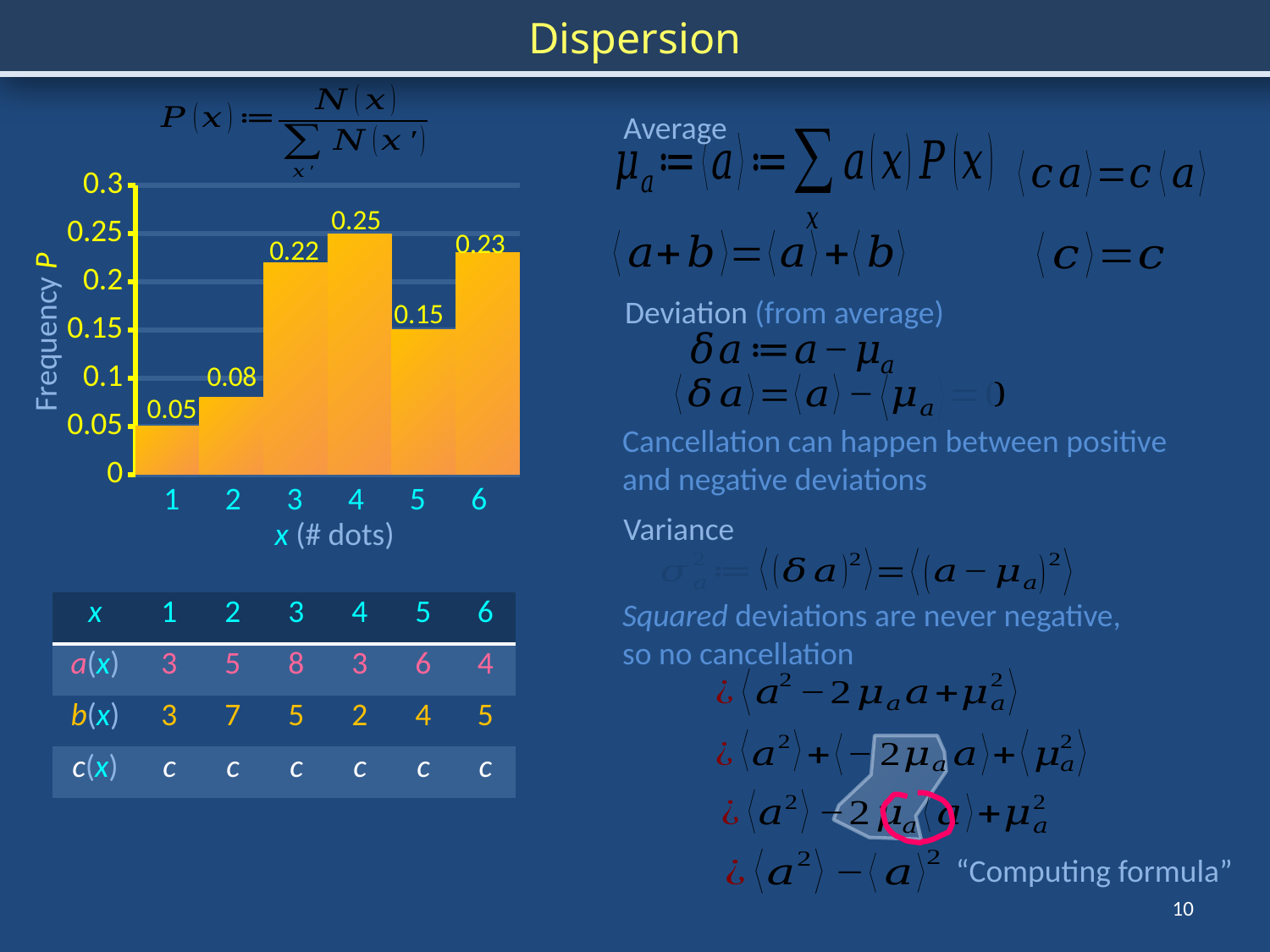
What is the difference between the frequency for x = 4 and the frequency for x = 1? 0.20 What is the frequency P for x = 1? 0.05 What is the frequency P for x = 4? 0.25 Which has a larger frequency P, x = 3 or x = 6? x = 6 What is the difference between the frequency for x = 6 and the frequency for x = 5? 0.08 Is the frequency P for x = 2 greater or less than 0.1? less What is the label of the vertical axis of the chart? Frequency P Which value of x has the highest frequency P? 4 How many values of x are plotted in the bar chart? 6 What is the frequency P for x = 5? 0.15 Which value of x has the lowest frequency P? 1 What kind of chart is shown on the slide? bar chart